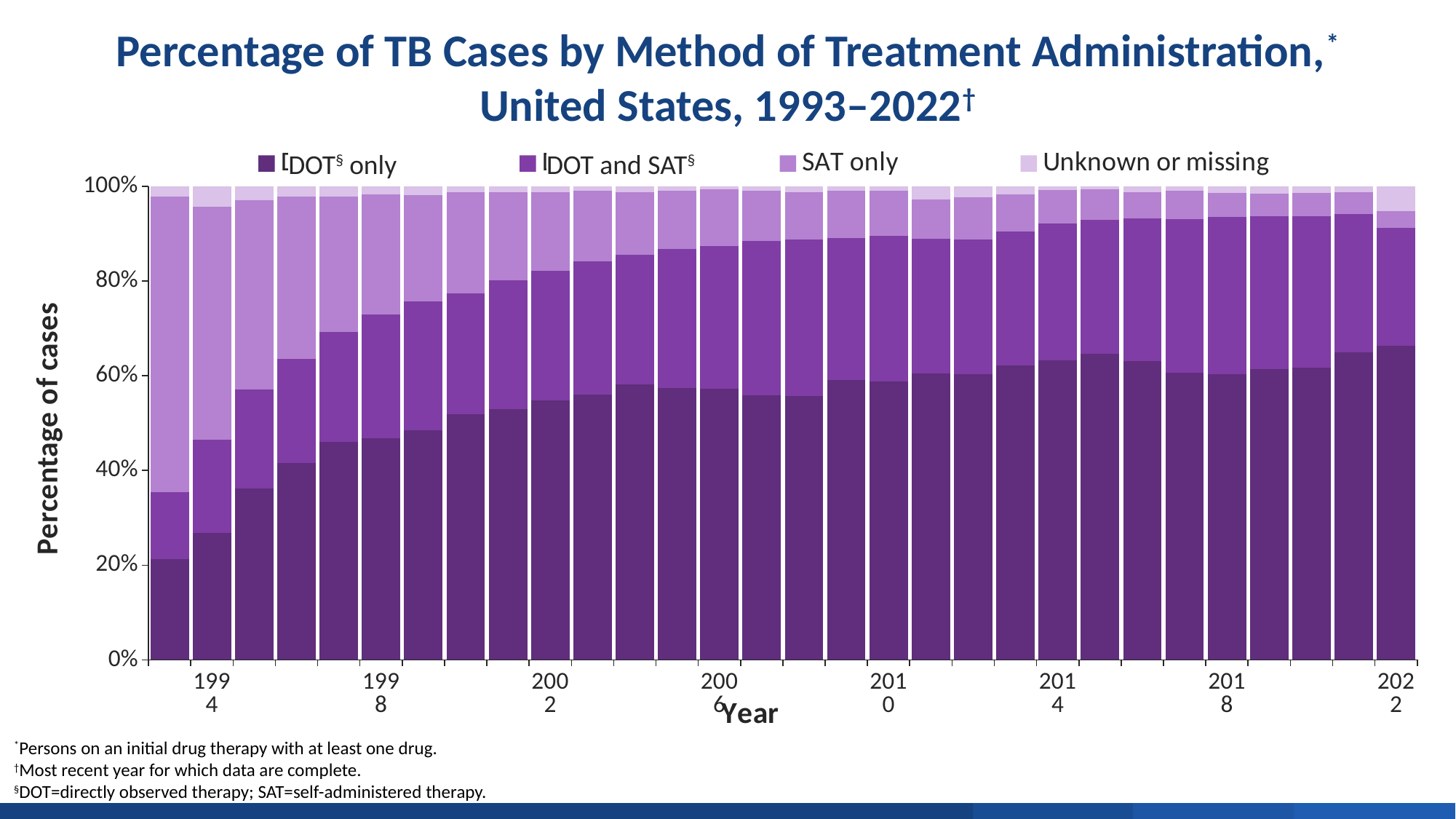
How many series does the legend list? 4 Which year has the smallest DOT only share? 1993 Is the DOT only share for 2014 greater or less than 60%? greater How many years (bars) are plotted in the chart? 30 Which is larger, the DOT only share in 1993 or in 2022? 2022 Is the SAT only share for 1993 greater or less than 40%? greater Is the DOT only share for 2022 greater or less than 60%? greater Does the SAT only share generally rise or fall from 1993 to 2022? Fall Does the DOT only share generally rise or fall from 1993 to 2022? Rise What is the label of the y axis? Percentage of cases What kind of chart is shown on the slide? Stacked bar chart